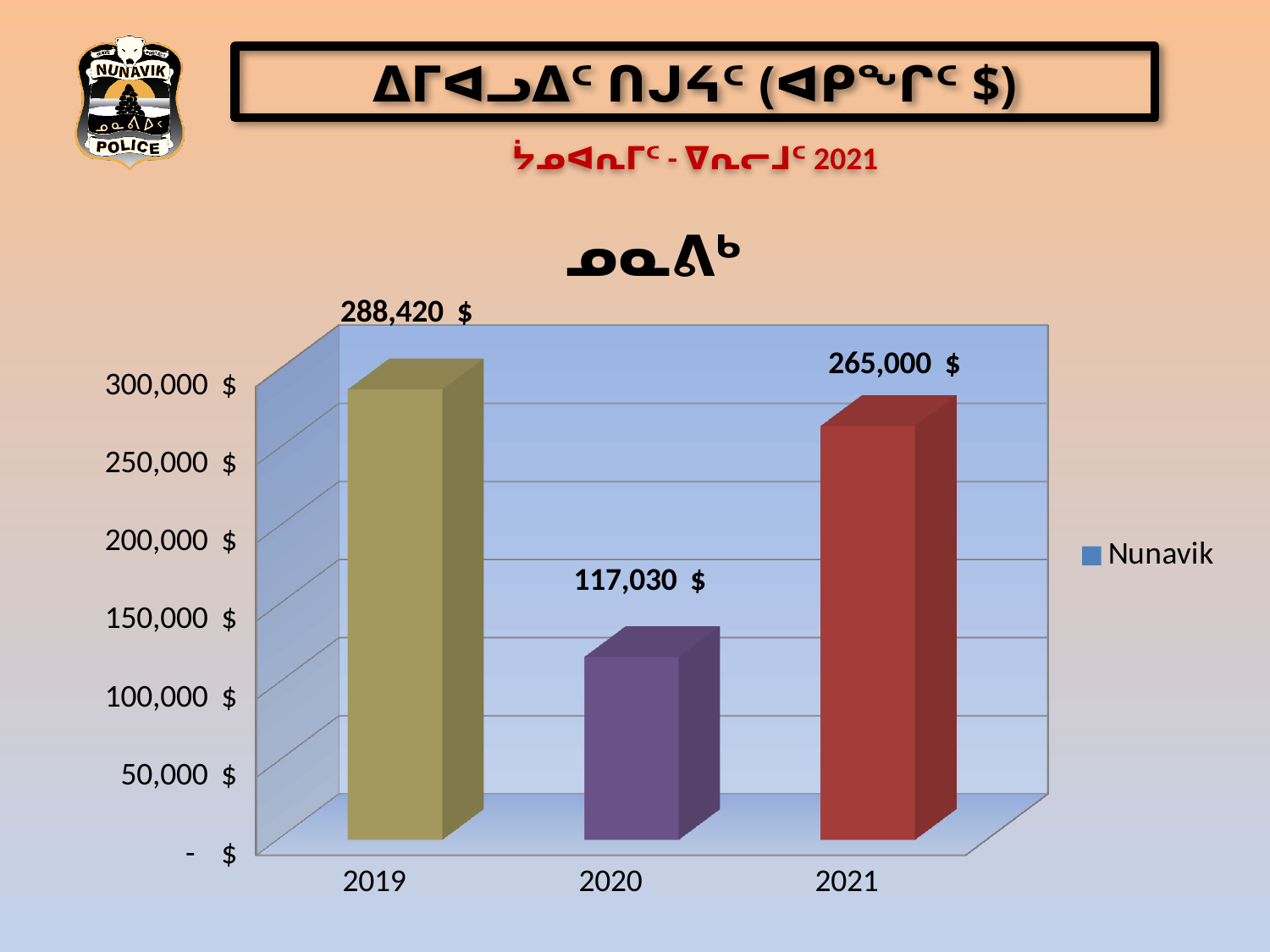
What series name does the legend show? Nunavik What is the value for 2020? 117,030 $ Which year has the lowest value? 2020 How many years are shown on the x axis? 3 What is the difference between the values for 2021 and 2020? 147,970 $ Which year has the highest value? 2019 What is the value for 2021? 265,000 $ Is the value for 2020 greater or less than 150,000 $? less Which is larger, the value for 2020 or the value for 2021? 2021 What is the value for 2019? 288,420 $ What kind of chart is shown on the slide? bar chart What is the difference between the values for 2019 and 2021? 23,420 $